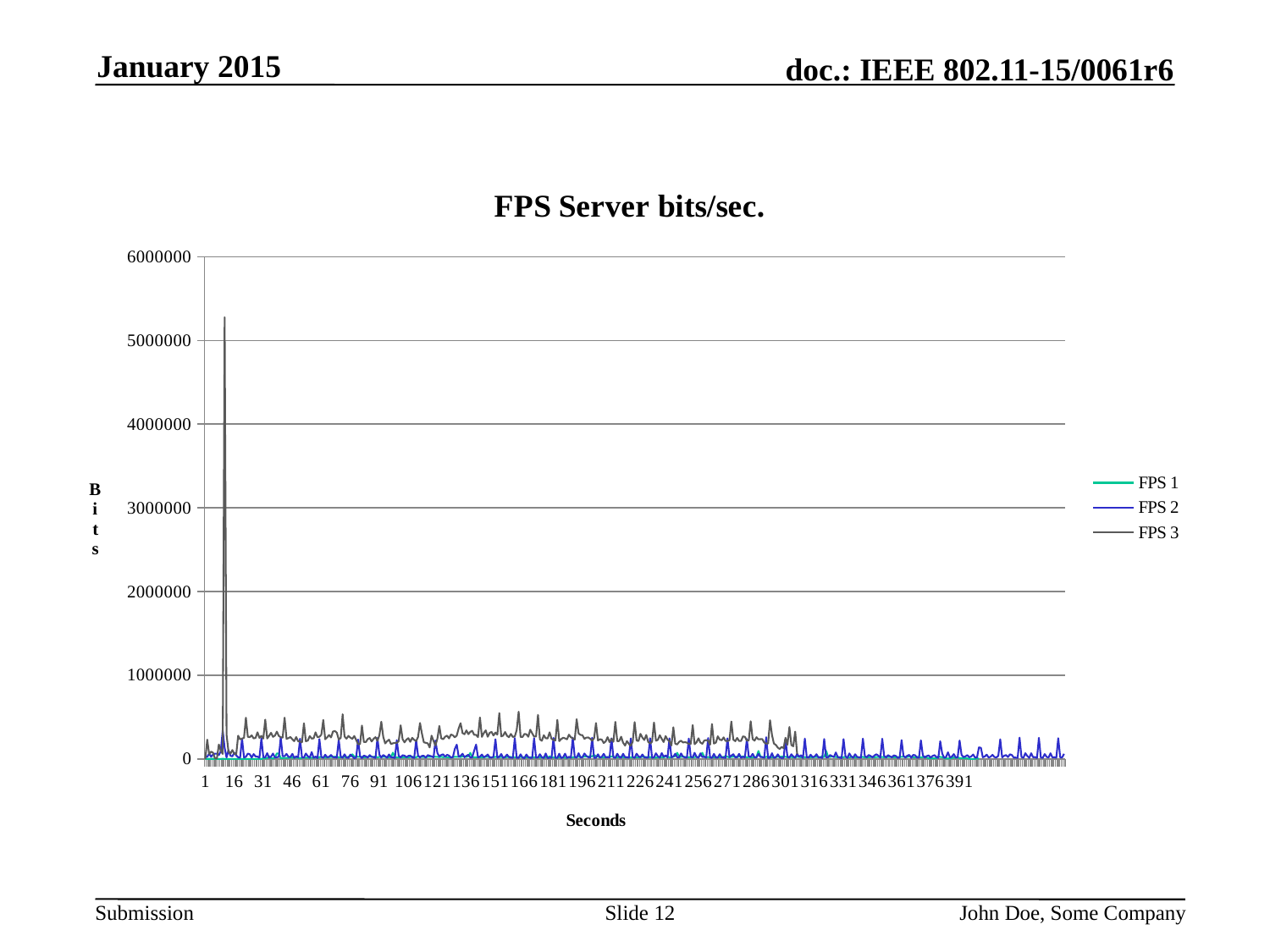
What kind of chart is shown on the slide? line chart What is the highest value shown on the y axis? 6000000 Is the highest peak of the FPS 2 series greater or less than 1000000? less What is the label of the x axis? Seconds What is the title of the chart? FPS Server bits/sec. Which series has the larger peak, FPS 2 or FPS 3? FPS 3 Which series reaches the highest peak value on the chart? FPS 3 How many series does the legend list? 3 Is the highest peak of the FPS 3 series greater or less than 5000000? greater Which series stays lowest across the chart, FPS 1 or FPS 3? FPS 1